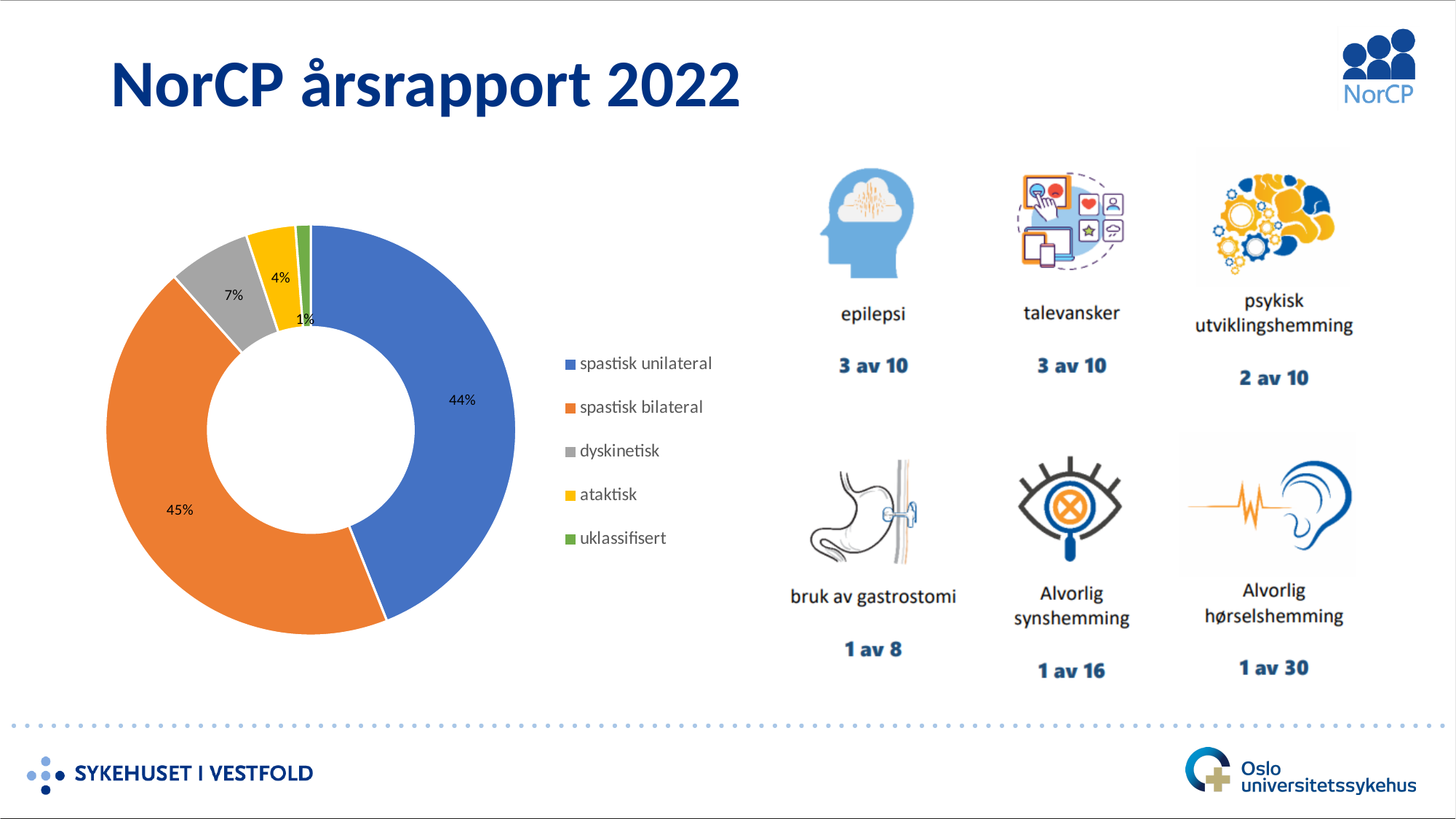
What share of the doughnut chart is spastisk unilateral? 44% What share of the doughnut chart is ataktisk? 4% What share of the doughnut chart is spastisk bilateral? 45% What is the difference in percentage points between dyskinetisk and ataktisk? 3 What kind of chart is shown on the slide? doughnut chart What colour is the spastisk bilateral slice in the doughnut chart? orange Which is larger, the share for dyskinetisk or the share for ataktisk? dyskinetisk What share of the doughnut chart is dyskinetisk? 7% What is the combined share of spastisk unilateral and spastisk bilateral? 89% How many categories does the doughnut chart show? 5 What share of the doughnut chart is uklassifisert? 1% Which category has the smallest share in the doughnut chart? uklassifisert